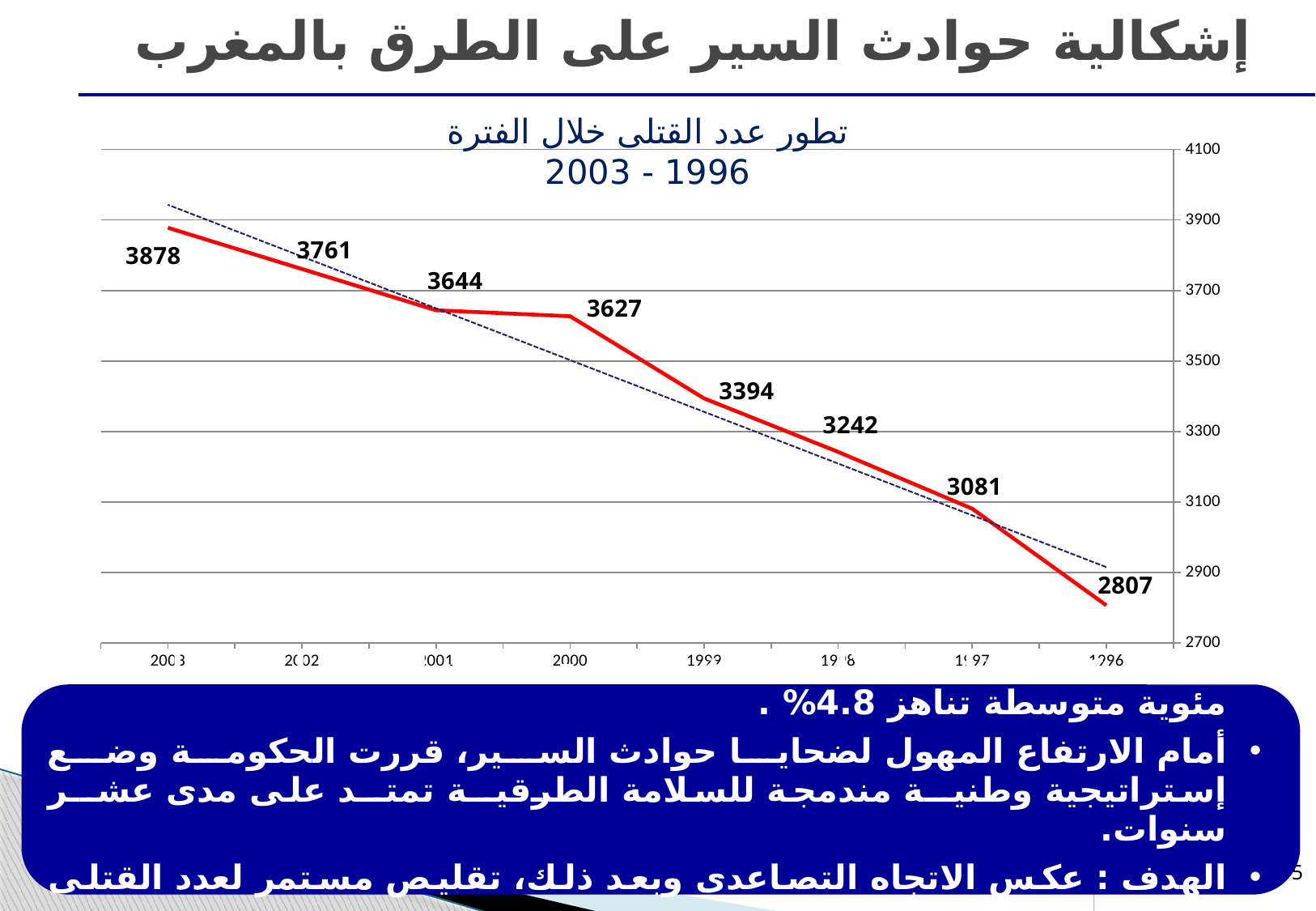
What kind of chart is shown on the slide? Line chart How many years (data points) are plotted on the chart? 8 Which year has a larger value, 1999 or 1997? 1999 Which year has the lowest number of deaths? 1996 From 1996 to 2003, do the number of deaths rise or fall? Rise What is the difference between the values for 2001 and 2000? 17 What is the number of deaths shown for 1996? 2807 What value is labelled for the year 1998? 3242 What is the number of deaths shown for 2003? 3878 Which year has the highest number of deaths? 2003 What value is labelled for the year 2000? 3627 What is the difference between the values for 2003 and 1996? 1071